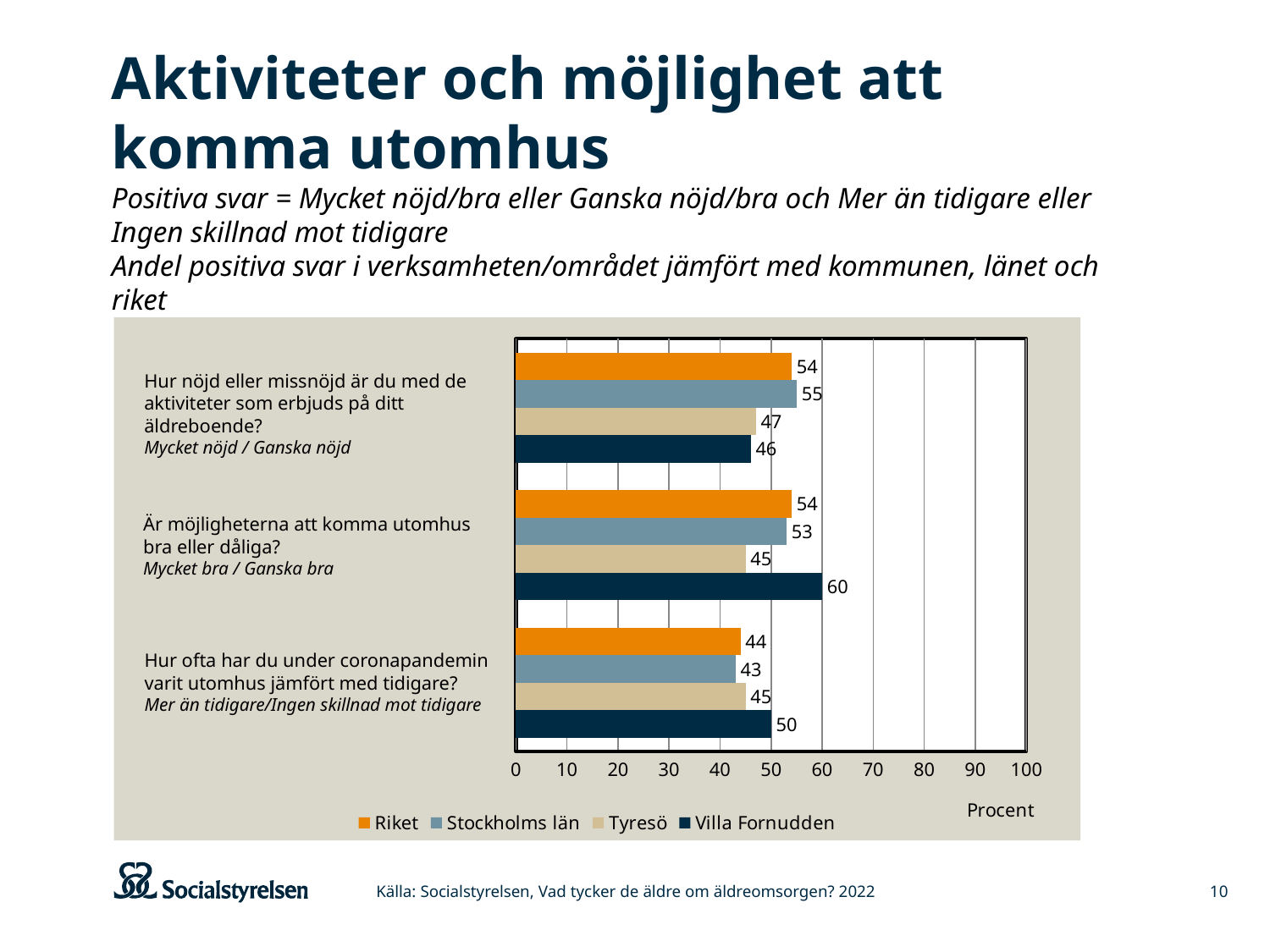
What is the value for Villa Fornudden on the question "Är möjligheterna att komma utomhus bra eller dåliga?"? 60 What is the value for Tyresö on the question "Hur nöjd eller missnöjd är du med de aktiviteter som erbjuds på ditt äldreboende?"? 47 Which series has the highest value on the question "Är möjligheterna att komma utomhus bra eller dåliga?"? Villa Fornudden Which is larger on the question "Hur ofta har du under coronapandemin varit utomhus jämfört med tidigare?": Riket or Villa Fornudden? Villa Fornudden What kind of chart is shown on the slide? Bar chart How many question categories are shown on the chart? 3 What unit label is shown on the horizontal axis of the chart? Procent How many series does the legend list? 4 What is the difference between Villa Fornudden and Tyresö on the question "Är möjligheterna att komma utomhus bra eller dåliga?"? 15 Which series has the lowest value on the question "Hur nöjd eller missnöjd är du med de aktiviteter som erbjuds på ditt äldreboende?"? Villa Fornudden Is the value for Villa Fornudden on the question "Hur nöjd eller missnöjd är du med de aktiviteter som erbjuds på ditt äldreboende?" greater or less than 50? less What is the value for Stockholms län on the question "Hur ofta har du under coronapandemin varit utomhus jämfört med tidigare?"? 43